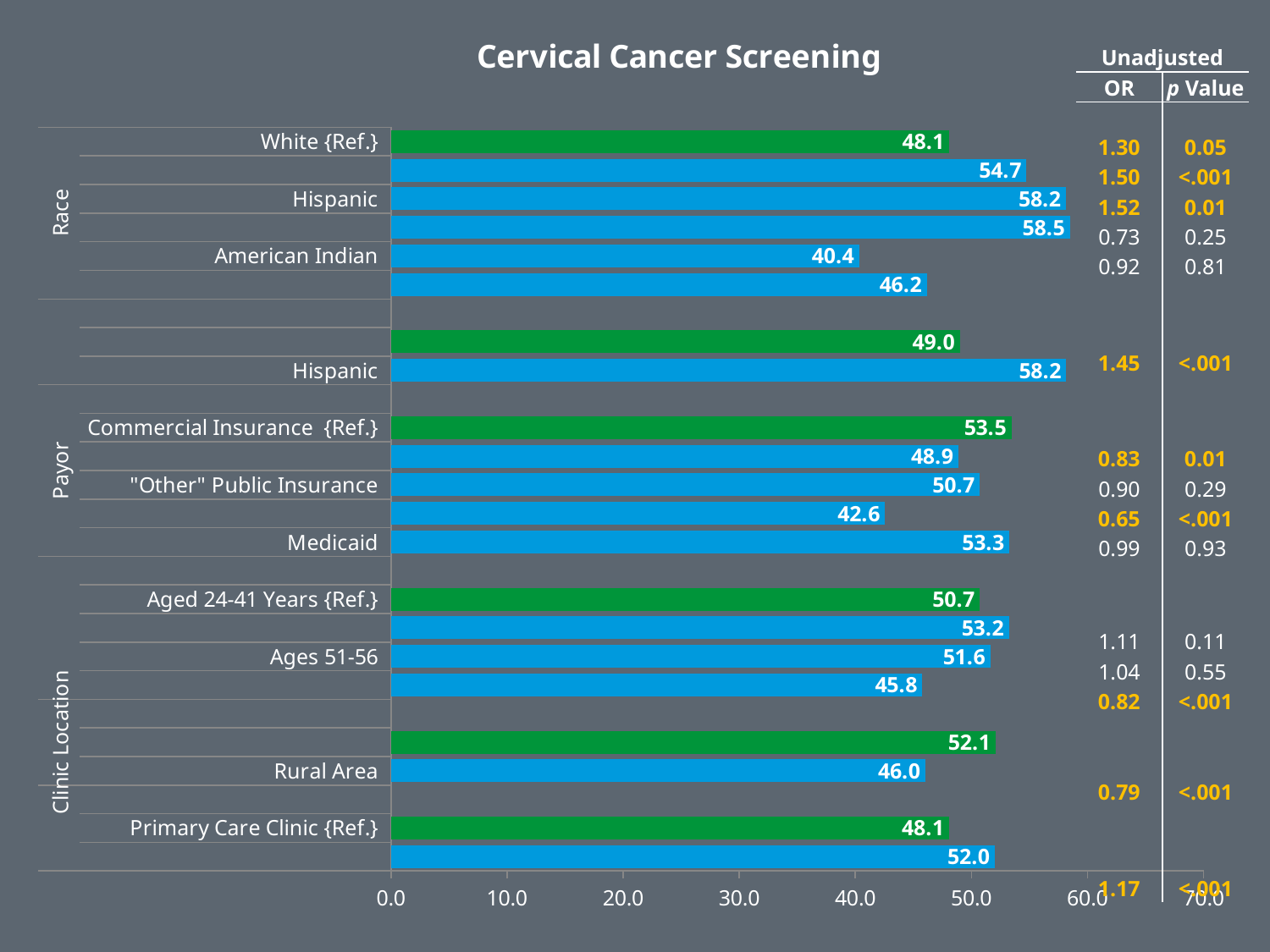
What is the difference between the values for Hispanic in the Race group and White {Ref.}? 10.1 Which is larger, the value for Commercial Insurance {Ref.} or the value for "Other" Public Insurance? Commercial Insurance {Ref.} What is the value for American Indian? 40.4 What is the value for Ages 51-56? 51.6 What is the value for Rural Area? 46.0 What is the value for Medicaid? 53.3 What type of chart is shown on the slide? bar chart What is the value for Commercial Insurance {Ref.}? 53.5 Is the value for Medicaid greater or less than 50.0? greater What is the title of the chart? Cervical Cancer Screening What is the value for White {Ref.} in the Race group? 48.1 What is the lowest value shown on the chart? 40.4